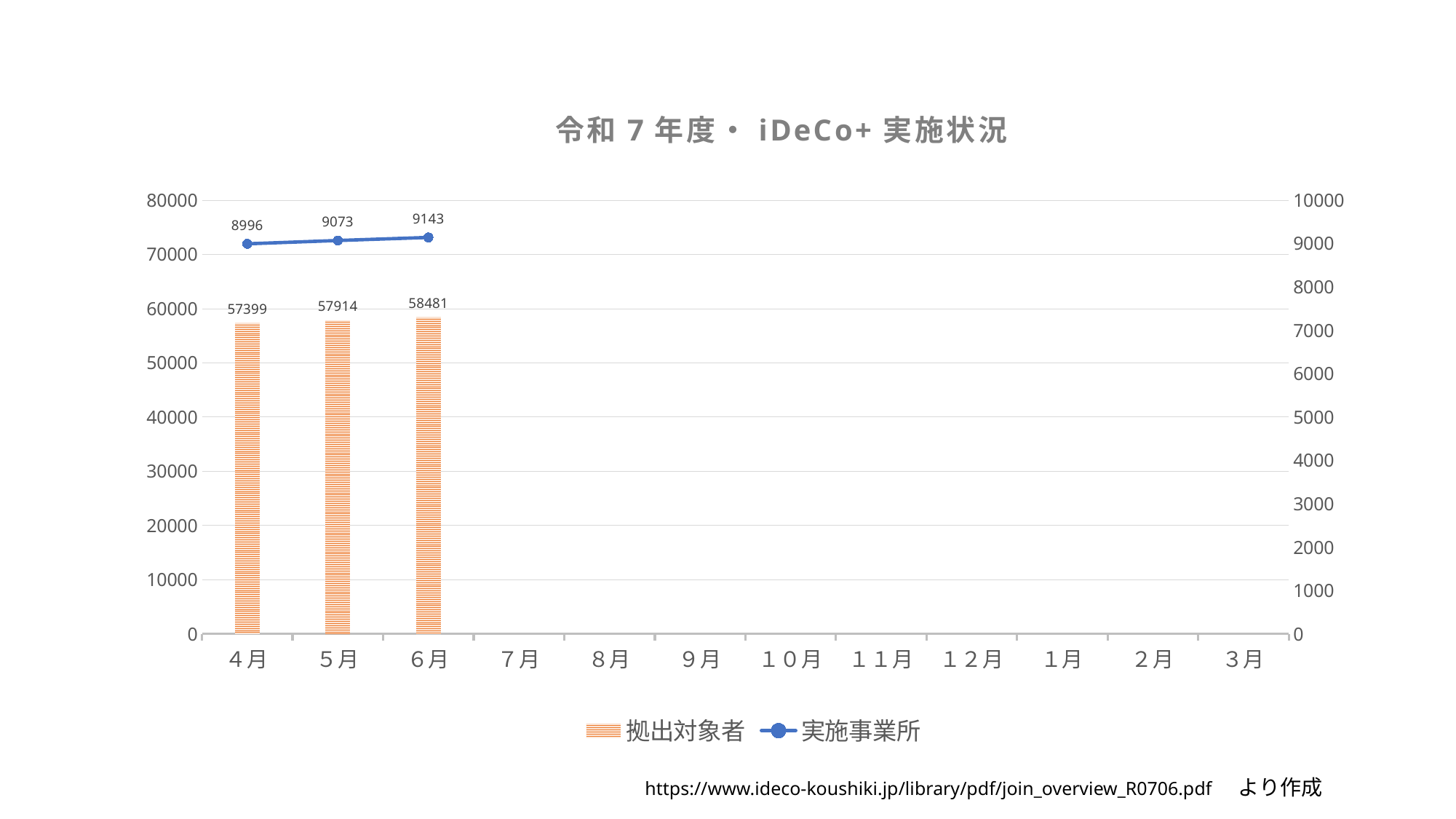
Which month has the lowest 実施事業所 value among the plotted months? 4月 What is the difference in 実施事業所 between 5月 and 4月? 77 Which month has the highest 拠出対象者 value among the plotted months? 6月 What is the value of 実施事業所 for 5月? 9073 How many series does the legend list? 2 What is the value of 実施事業所 for 6月? 9143 Do the 実施事業所 values rise or fall from 4月 to 6月? rise What is the value of 拠出対象者 for 4月? 57399 What is the difference in 拠出対象者 between 6月 and 4月? 1082 How many months have plotted data for 拠出対象者? 3 Which is larger, the 拠出対象者 value for 5月 or for 4月? 5月 What is the title of the chart? 令和7年度・iDeCo+実施状況